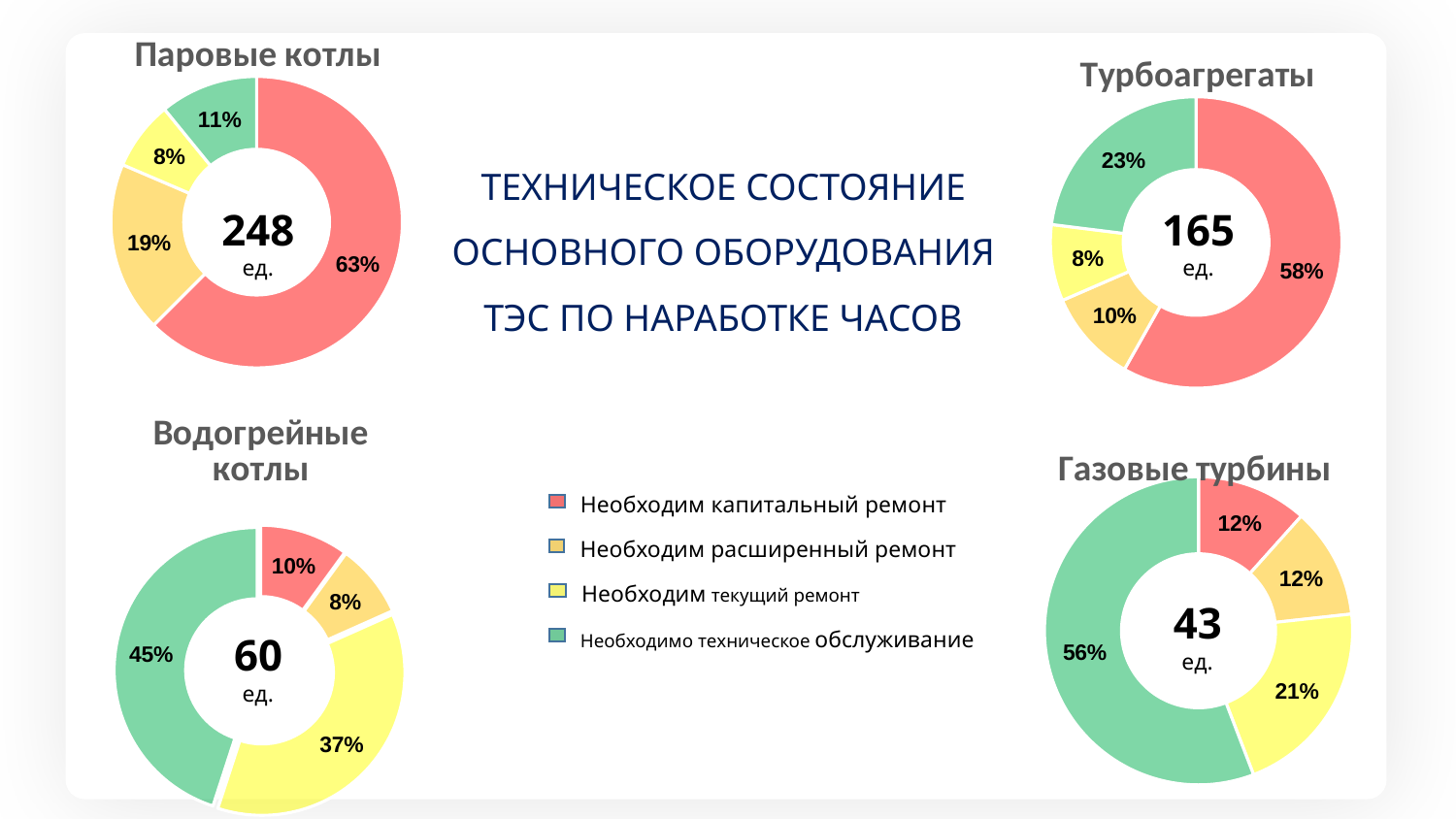
In the "Турбоагрегаты" chart, what share of units needs technical maintenance (Необходимо техническое обслуживание)? 23% How many donut charts are shown on the slide? 4 How many categories does the legend list? 4 In the "Газовые турбины" chart, which category has the largest share? Необходимо техническое обслуживание In the "Паровые котлы" chart, what share of units needs capital repair (Необходим капитальный ремонт)? 63% In the "Водогрейные котлы" chart, what share of units needs current repair (Необходим текущий ремонт)? 37% How many units does the "Турбоагрегаты" chart represent in total? 165 ед. In the "Газовые турбины" chart, what share of units needs extended repair (Необходим расширенный ремонт)? 12% In the "Паровые котлы" chart, which category has the smallest share? Необходим текущий ремонт What type of chart is used for "Газовые турбины"? Donut (pie) chart In the "Водогрейные котлы" chart, what is the difference between the share needing technical maintenance and the share needing current repair? 8% Which is larger: the share needing capital repair in the "Паровые котлы" chart or in the "Турбоагрегаты" chart? Паровые котлы